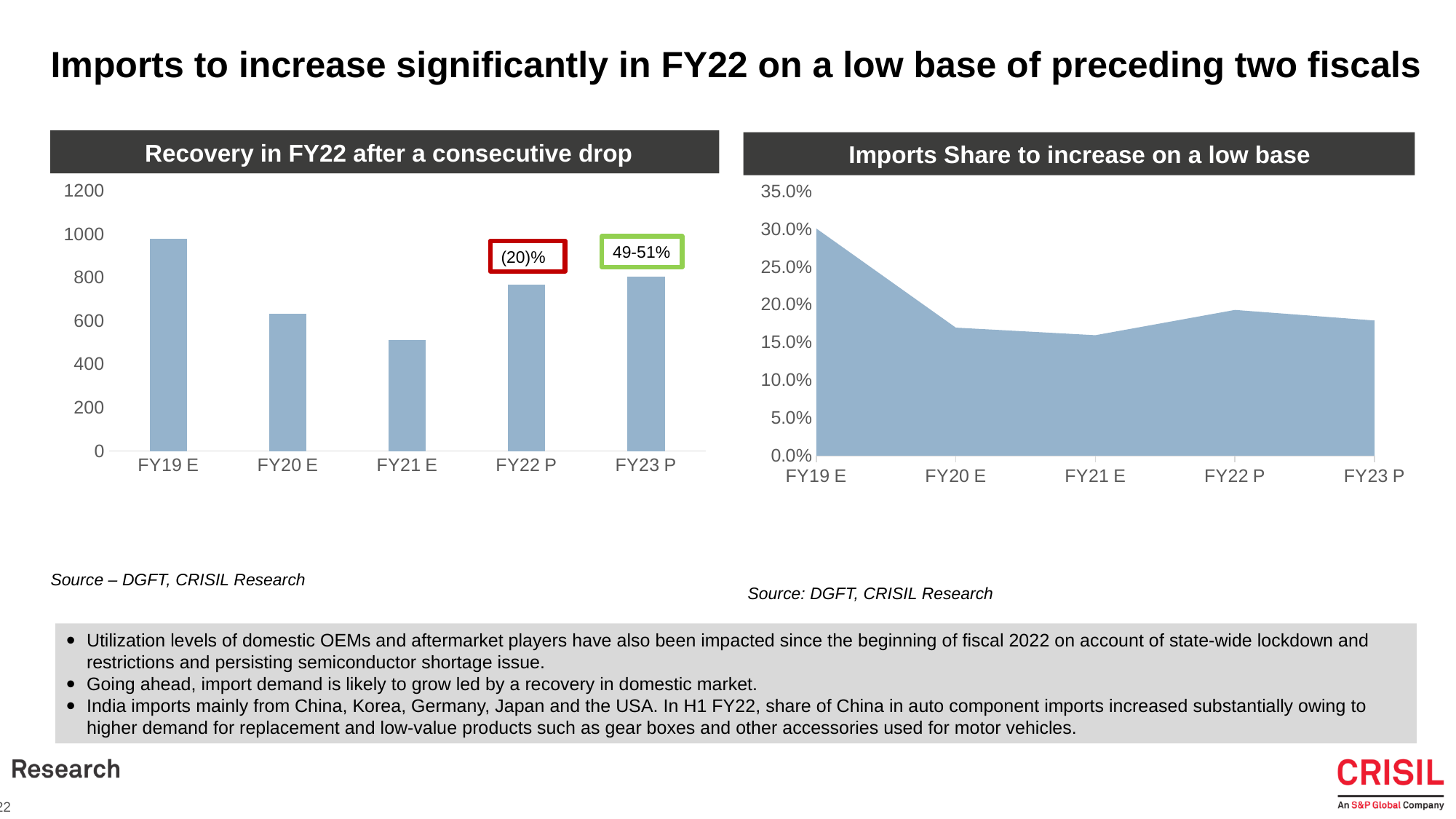
In "Recovery in FY22 after a consecutive drop", which fiscal year has the tallest bar? FY19 E In "Recovery in FY22 after a consecutive drop", what growth range is annotated above the FY23 P bar? 49-51% In "Recovery in FY22 after a consecutive drop", is the value for FY20 E greater or less than 800? less In "Recovery in FY22 after a consecutive drop", which is larger, the bar for FY20 E or the bar for FY22 P? FY22 P In "Recovery in FY22 after a consecutive drop", which fiscal year has the shortest bar? FY21 E In "Recovery in FY22 after a consecutive drop", is the value for FY19 E greater or less than 800? greater In "Imports Share to increase on a low base", which fiscal year has the highest import share? FY19 E What kind of chart is "Recovery in FY22 after a consecutive drop"? bar chart In "Imports Share to increase on a low base", is the value for FY21 E greater or less than 20.0%? less In "Imports Share to increase on a low base", does the import share rise or fall from FY19 E to FY21 E? fall What kind of chart is "Imports Share to increase on a low base"? area chart How many fiscal years are shown on the x axis of "Recovery in FY22 after a consecutive drop"? 5